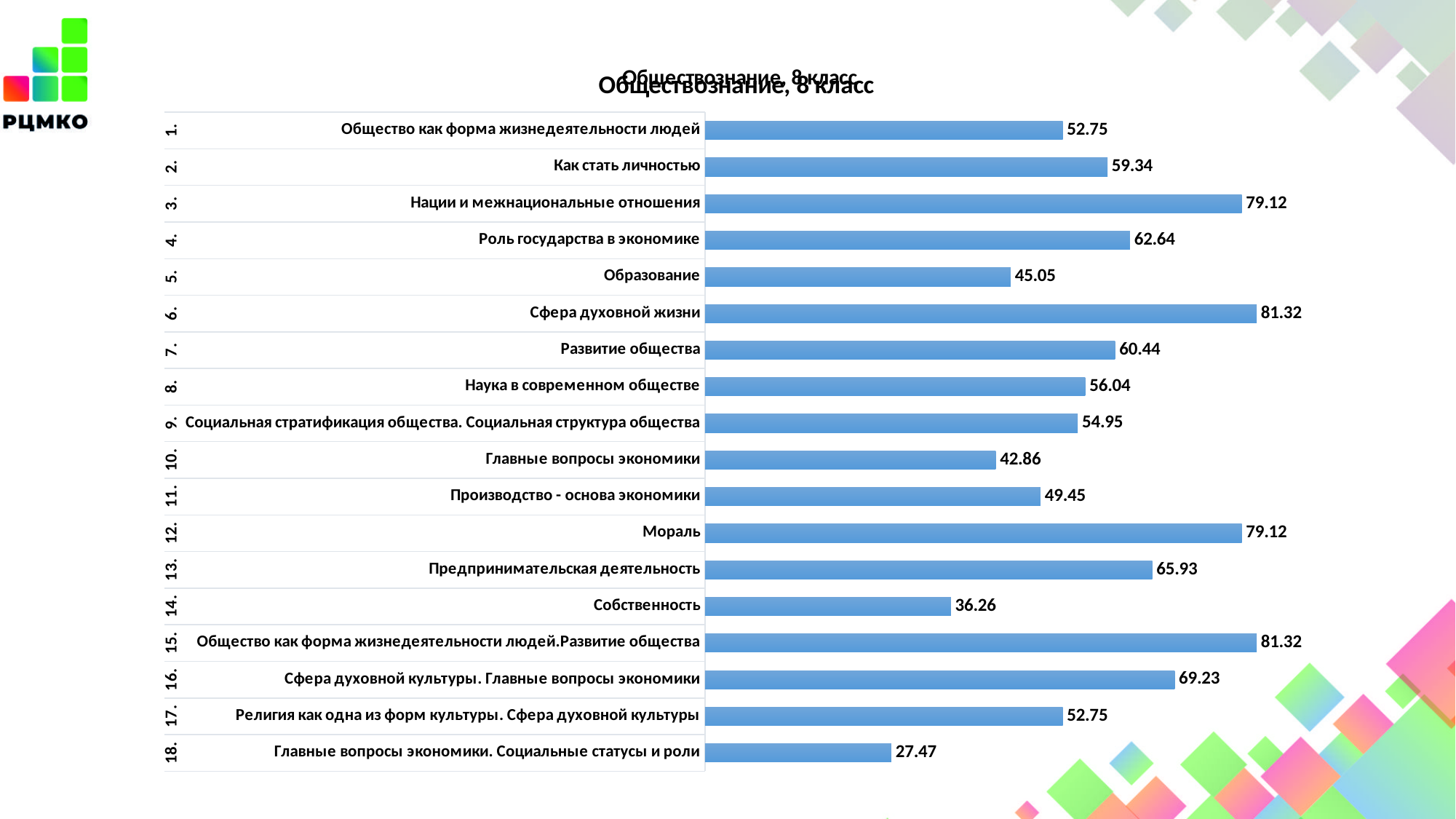
What is the title of the chart? Обществознание, 8 класс What type of chart is shown on the slide? Bar chart What is the value for "Образование"? 45.05 Which topic has the lowest value? Главные вопросы экономики. Социальные статусы и роли What is the highest value shown in the chart? 81.32 What is the value for "Мораль"? 79.12 Which is larger: the value for "Роль государства в экономике" or the value for "Как стать личностью"? Роль государства в экономике How many categories (topics) are plotted in the chart? 18 What is the value for "Собственность"? 36.26 What is the difference between the values for "Предпринимательская деятельность" and "Собственность"? 29.67 What is the difference between the values for "Сфера духовной жизни" and "Главные вопросы экономики. Социальные статусы и роли"? 53.85 What is the value for "Предпринимательская деятельность"? 65.93